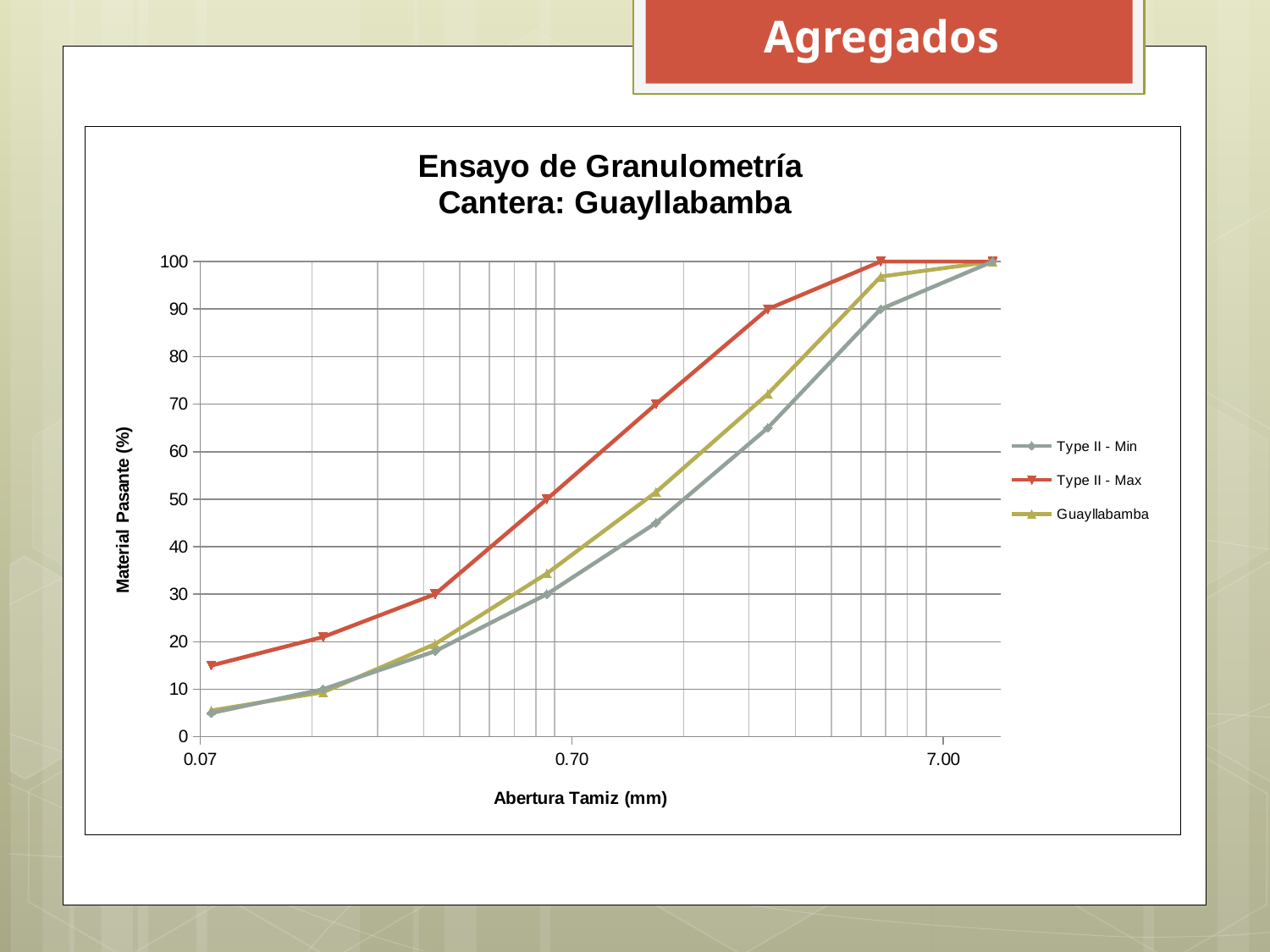
Which series has the highest values across the middle of the chart? Type II - Max At the leftmost sieve opening (0.07 mm), is the value for Type II - Min greater or less than 10? less At the leftmost sieve opening (0.07 mm), is the value for Type II - Max greater or less than 10? greater What kind of chart is shown on the slide? line chart How many data points are plotted for the Type II - Max series? 8 How many series does the legend list? 3 Do the values of the Guayllabamba series rise or fall as the sieve opening increases along the x axis? rise What is the title of the chart? Ensayo de Granulometría Cantera: Guayllabamba Which series has the lowest values across the middle of the chart? Type II - Min At the leftmost sieve opening (0.07 mm), which series has the higher value, Type II - Max or Type II - Min? Type II - Max What is the highest value shown on the vertical axis? 100 What is the label of the vertical axis? Material Pasante (%)